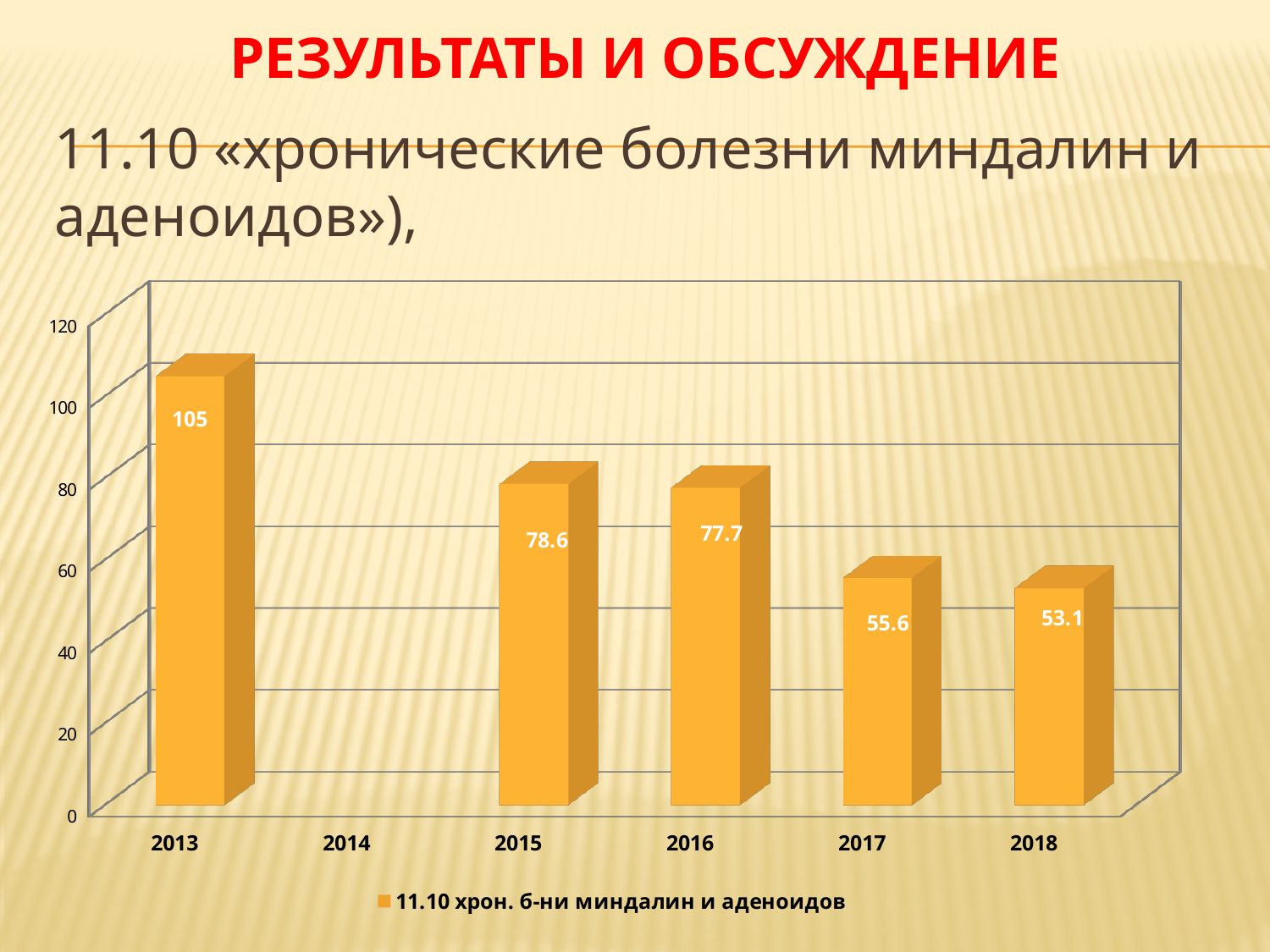
What is the value for 2013? 105 Which year with a plotted bar has the lowest value? 2018 Do the values generally rise or fall from 2013 to 2018? fall Which year has the highest value? 2013 What is the value for 2018? 53.1 How many bars are plotted on the chart? 5 What is the difference between the values for 2013 and 2018? 51.9 What kind of chart is shown? bar chart Is the value for 2016 greater or less than 80? less Which is larger, the value for 2015 or the value for 2016? 2015 What is the value for 2015? 78.6 What is the value for 2017? 55.6